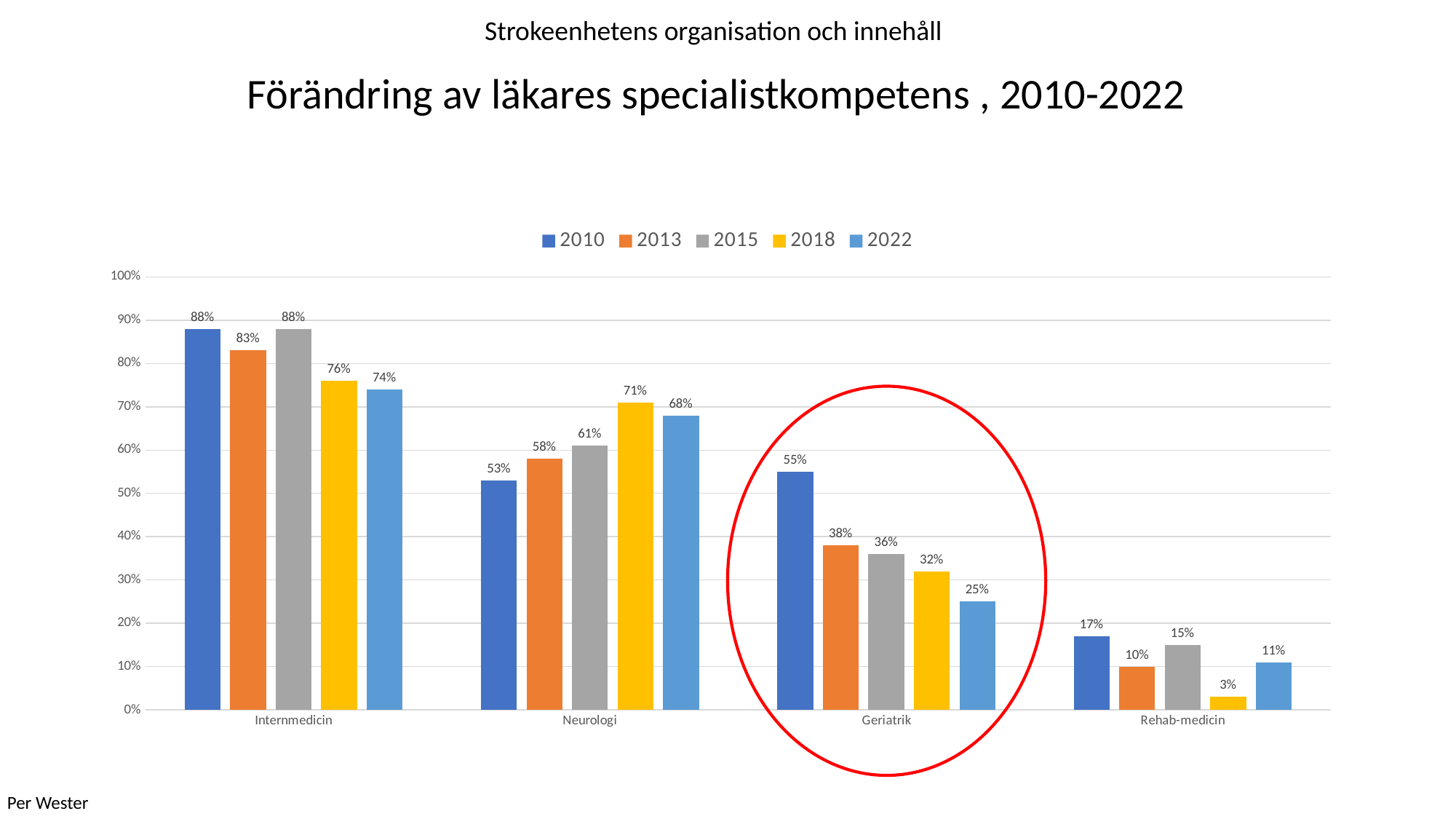
What is the difference between the 2010 and 2022 values for Geriatrik? 30% Which category has the lowest value in 2013? Rehab-medicin Which category has the highest value in 2022? Internmedicin How many categories are shown on the x axis? 4 What is the value for Geriatrik in 2010? 55% Which is larger for Neurologi: the 2018 value or the 2015 value? 2018 What is the value for Rehab-medicin in 2018? 3% What is the value for Neurologi in 2022? 68% How many series does the legend list? 5 Which category is circled in red on the chart? Geriatrik What kind of chart is shown on the slide? Bar chart Do the values for Geriatrik rise or fall from 2010 to 2022? Fall